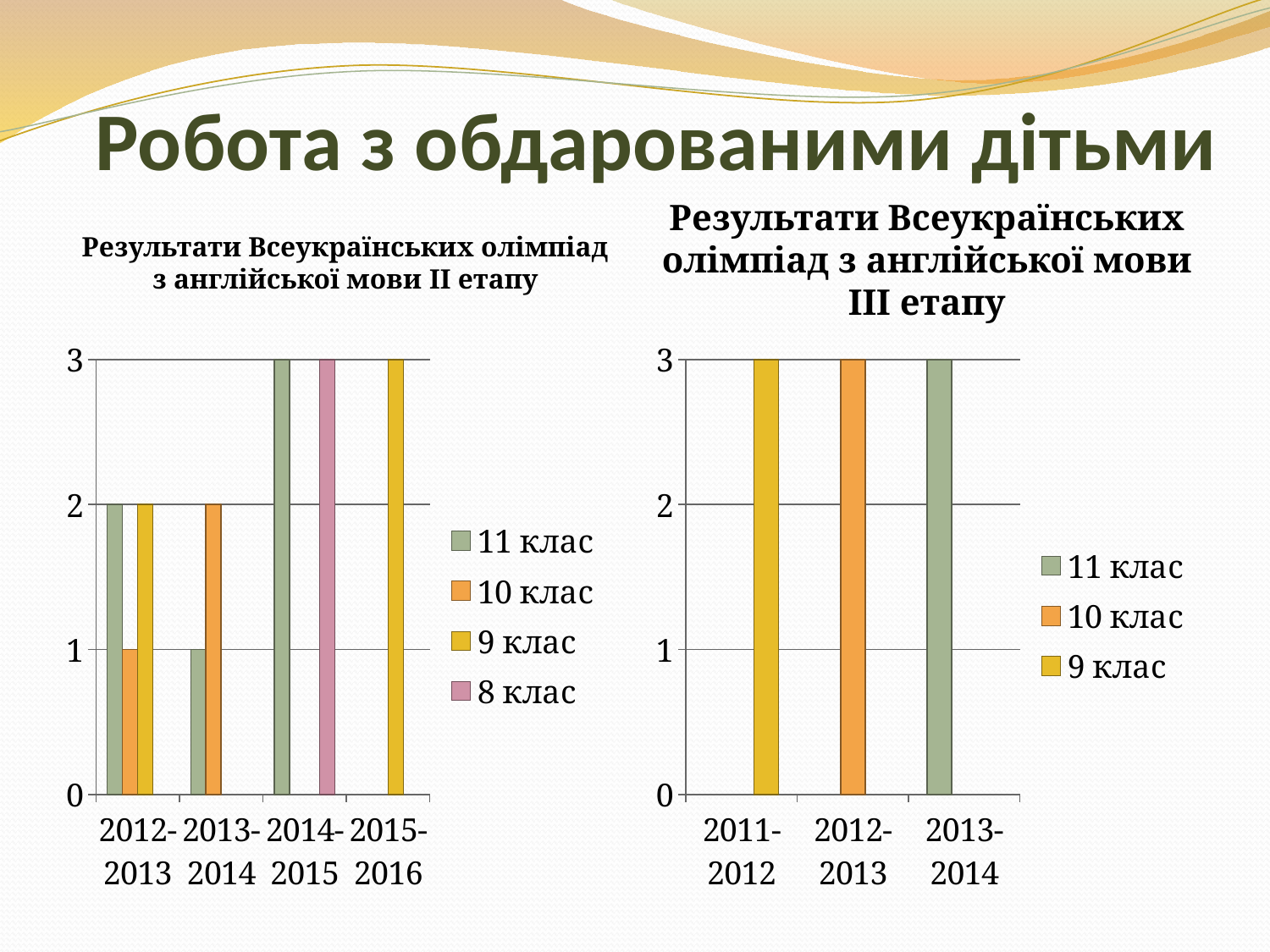
How many year categories are shown on the x axis of the chart 'Результати Всеукраїнських олімпіад з англійської мови ІІ етапу'? 4 How many series does the legend of the chart 'Результати Всеукраїнських олімпіад з англійської мови ІІ етапу' list? 4 In the chart 'Результати Всеукраїнських олімпіад з англійської мови ІІ етапу', what is the value for 10 клас in 2012-2013? 1 How many series does the legend of the chart 'Результати Всеукраїнських олімпіад з англійської мови ІІІ етапу' list? 3 In the chart 'Результати Всеукраїнських олімпіад з англійської мови ІІІ етапу', what is the value for 11 клас in 2013-2014? 3 In the chart 'Результати Всеукраїнських олімпіад з англійської мови ІІІ етапу', which series has a bar in 2012-2013? 10 клас In the chart 'Результати Всеукраїнських олімпіад з англійської мови ІІ етапу', what is the difference between 11 клас in 2014-2015 and 11 клас in 2013-2014? 2 What kind of chart is 'Результати Всеукраїнських олімпіад з англійської мови ІІІ етапу'? bar chart In the chart 'Результати Всеукраїнських олімпіад з англійської мови ІІ етапу', what is the value for 9 клас in 2015-2016? 3 In the chart 'Результати Всеукраїнських олімпіад з англійської мови ІІ етапу', what is the value for 11 клас in 2012-2013? 2 In the chart 'Результати Всеукраїнських олімпіад з англійської мови ІІ етапу', which is larger in 2013-2014: 11 клас or 10 клас? 10 клас In the chart 'Результати Всеукраїнських олімпіад з англійської мови ІІІ етапу', what is the value for 9 клас in 2011-2012? 3